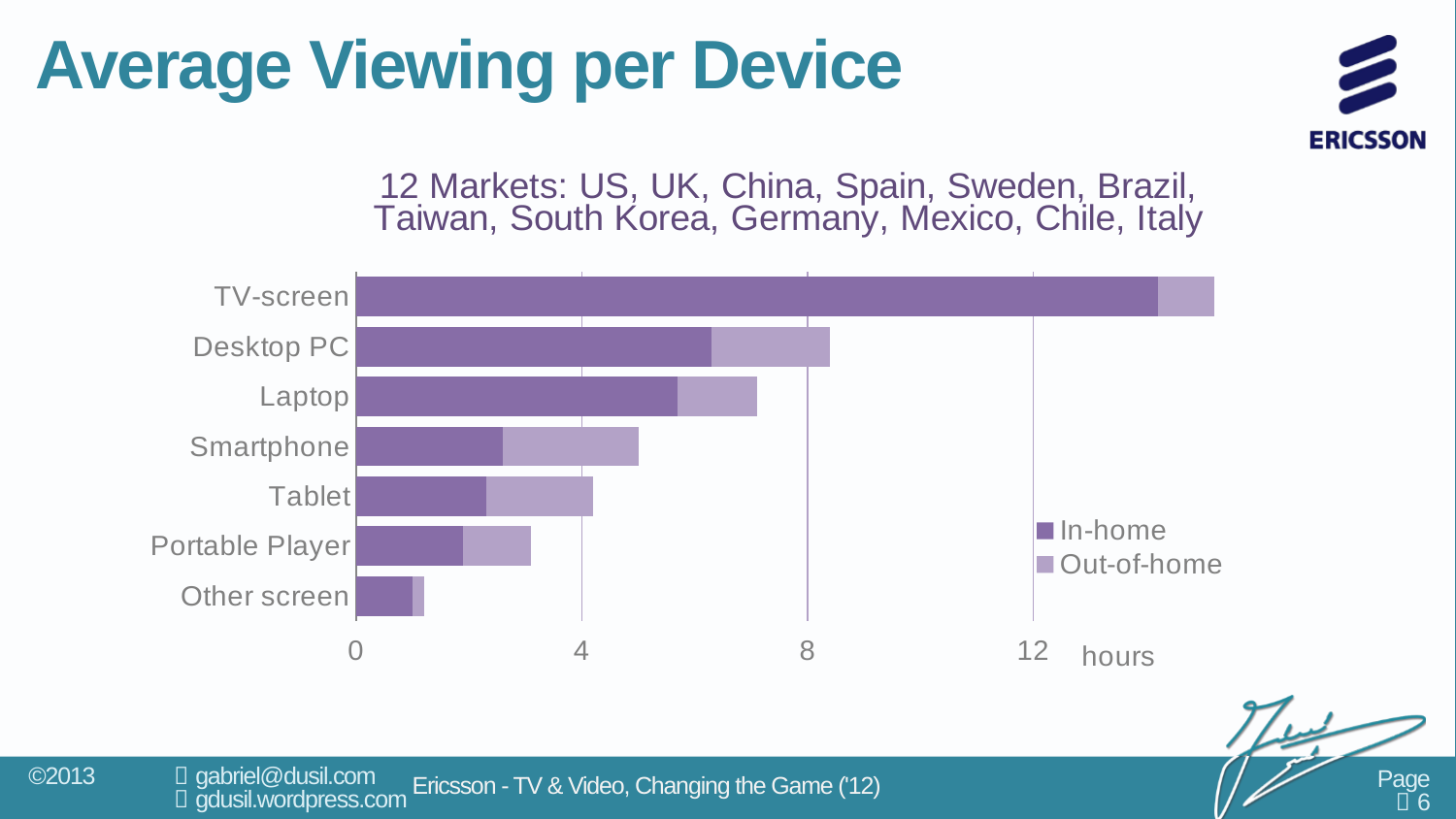
How many series does the legend list? 2 Is the In-home value for Desktop PC greater or less than 4? greater Is the total value for TV-screen greater or less than 12? greater Which device has the lowest total average viewing? Other screen What unit is shown on the horizontal axis of the chart? hours Is the total value for Portable Player greater or less than 4? less Which has the larger total average viewing, Desktop PC or Laptop? Desktop PC How many device categories are plotted in the chart? 7 Which device has the highest total average viewing? TV-screen What kind of chart is shown on the slide? bar chart